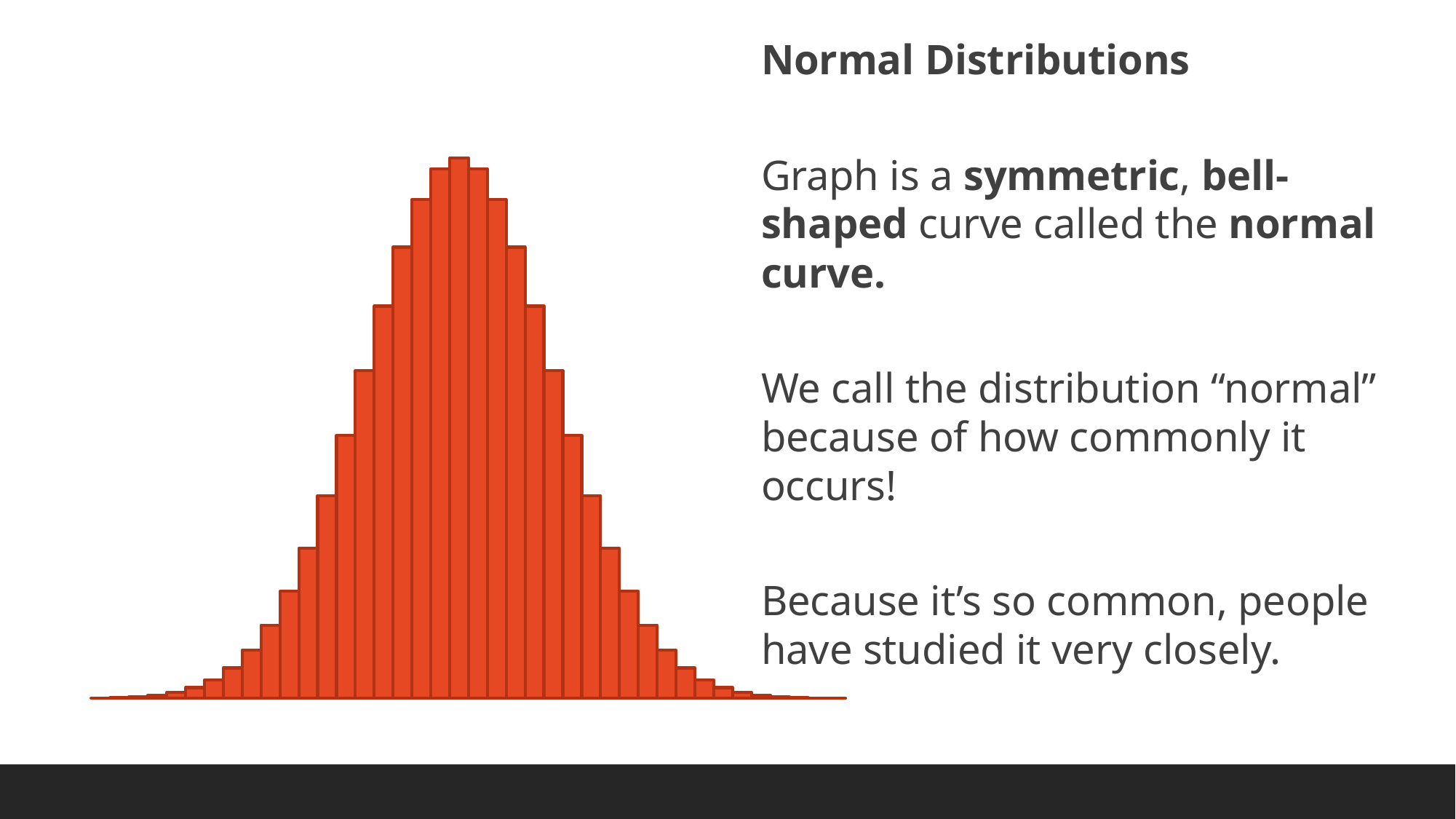
Is the bar at the far left of the chart taller or shorter than the bar at the centre? shorter Do the bar heights rise or fall moving from the centre of the chart toward the right edge? fall What colour are the bars in the chart? orange-red Where is the tallest bar located in the chart: at the left, in the middle, or at the right? in the middle Do the bar heights rise or fall moving from the left edge toward the centre of the chart? rise What kind of chart is shown on the slide? bar chart Does the chart include a legend? no